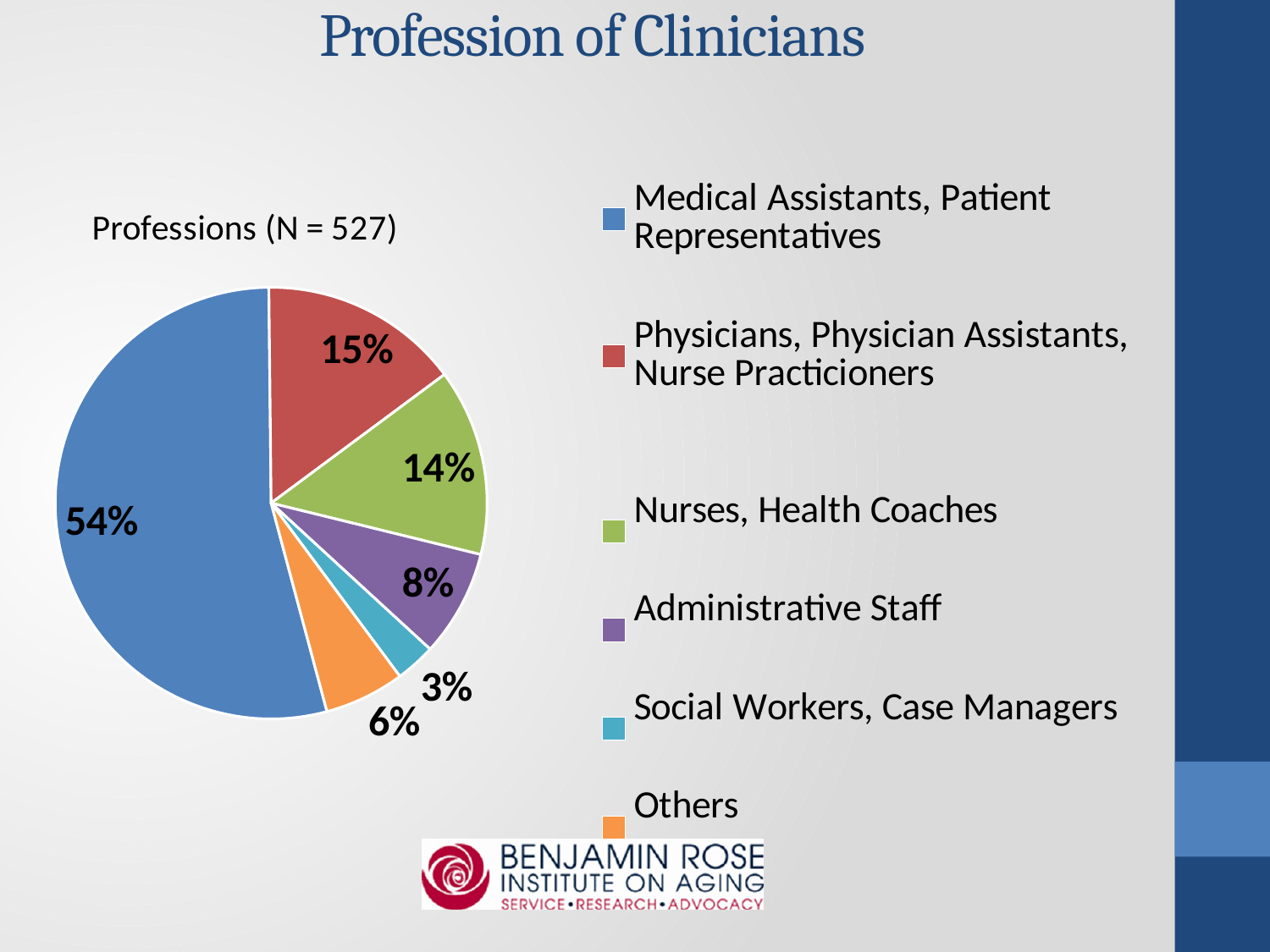
Which profession category has the largest share of the pie? Medical Assistants, Patient Representatives What percentage of clinicians are Nurses, Health Coaches? 14% What percentage of clinicians are Physicians, Physician Assistants, Nurse Practicioners? 15% What percentage of clinicians are Medical Assistants, Patient Representatives? 54% What percentage of clinicians fall under Others? 6% What is the title of the chart? Professions (N = 527) Which profession category has the smallest share of the pie? Social Workers, Case Managers What is the difference in percentage points between Administrative Staff and Others? 2% What percentage of clinicians are Social Workers, Case Managers? 3% What kind of chart is shown on the slide? Pie chart How many categories does the legend list? 6 What percentage of clinicians are Administrative Staff? 8%